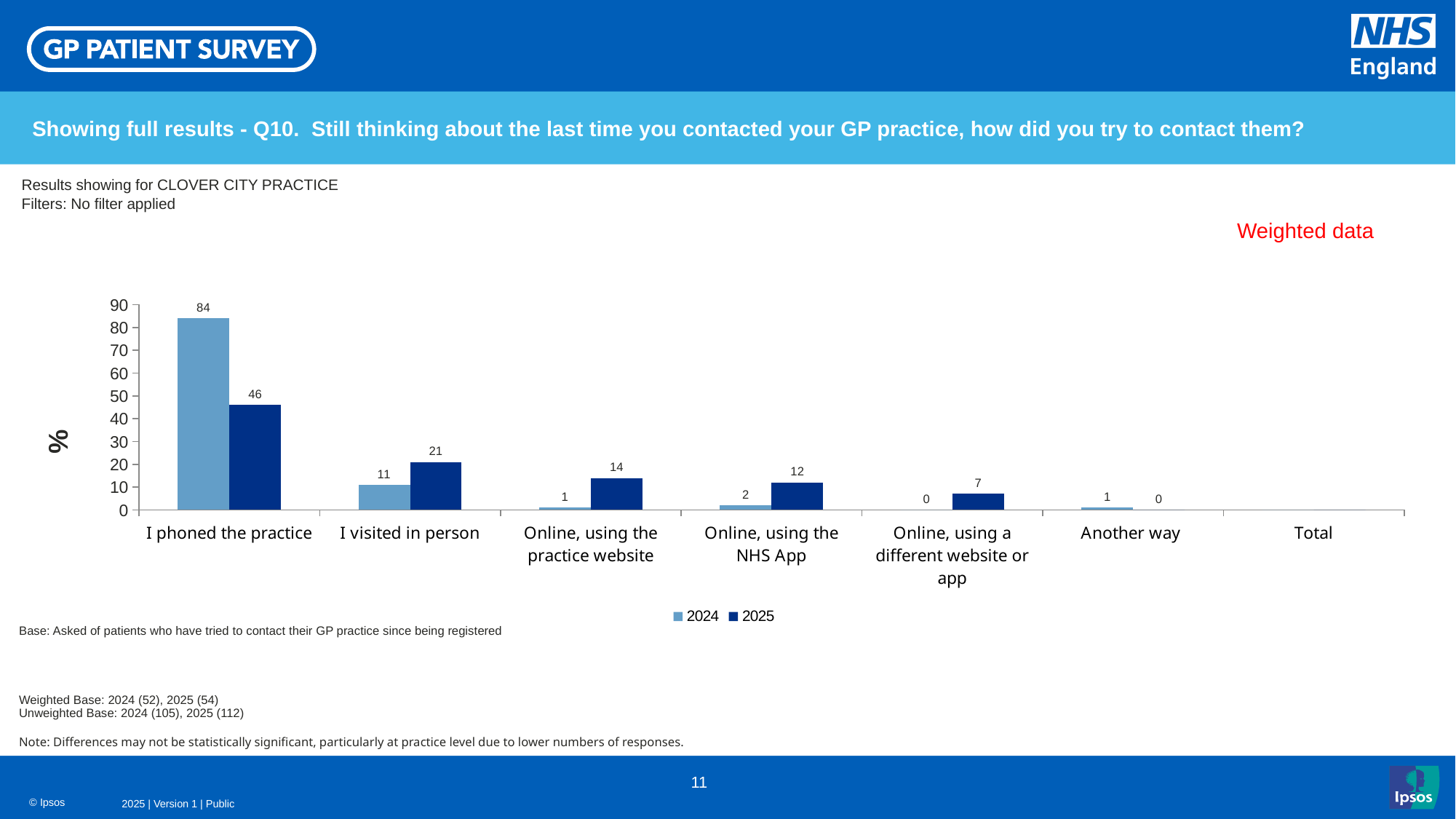
What is the difference between the 2024 and 2025 values for 'I phoned the practice'? 38 What is the 2025 value for 'Online, using a different website or app'? 7 What is the difference between the 2025 and 2024 values for 'I visited in person'? 10 What is the 2024 value for 'I phoned the practice'? 84 How many series does the legend list? 2 Which is larger for 'Online, using the practice website': the 2024 value or the 2025 value? 2025 Which category has the highest 2025 value? I phoned the practice What is the 2025 value for 'I visited in person'? 21 What is the 2025 value for 'Online, using the NHS App'? 12 Is the 2025 value for 'I phoned the practice' greater or less than 50? less What kind of chart is shown on the slide? bar chart What label is shown on the y axis of the chart? %